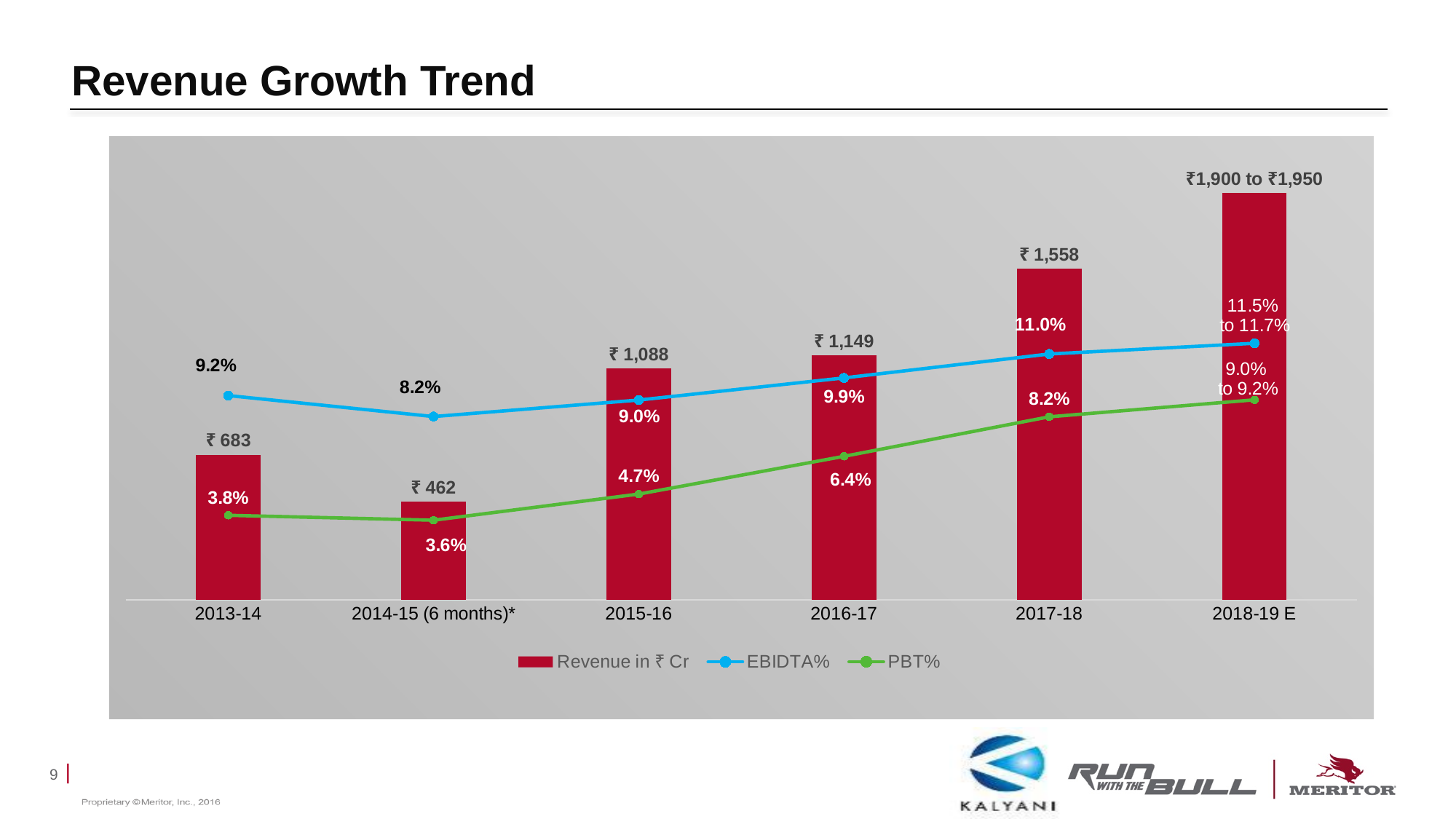
What is the revenue for 2015-16? ₹ 1,088 Does the PBT% rise or fall from 2014-15 (6 months)* to 2017-18? rise What is the title of the slide? Revenue Growth Trend Which is larger, the EBIDTA% for 2013-14 or for 2015-16? 2013-14 Which period has the lowest PBT%? 2014-15 (6 months)* What is the PBT% for 2017-18? 8.2% What revenue range is shown for 2018-19 E? ₹1,900 to ₹1,950 How many series does the legend list? 3 Which period has the lowest revenue bar? 2014-15 (6 months)* What is the difference in revenue between 2017-18 and 2016-17? ₹ 409 How many periods are shown on the x axis? 6 What is the EBIDTA% for 2016-17? 9.9%